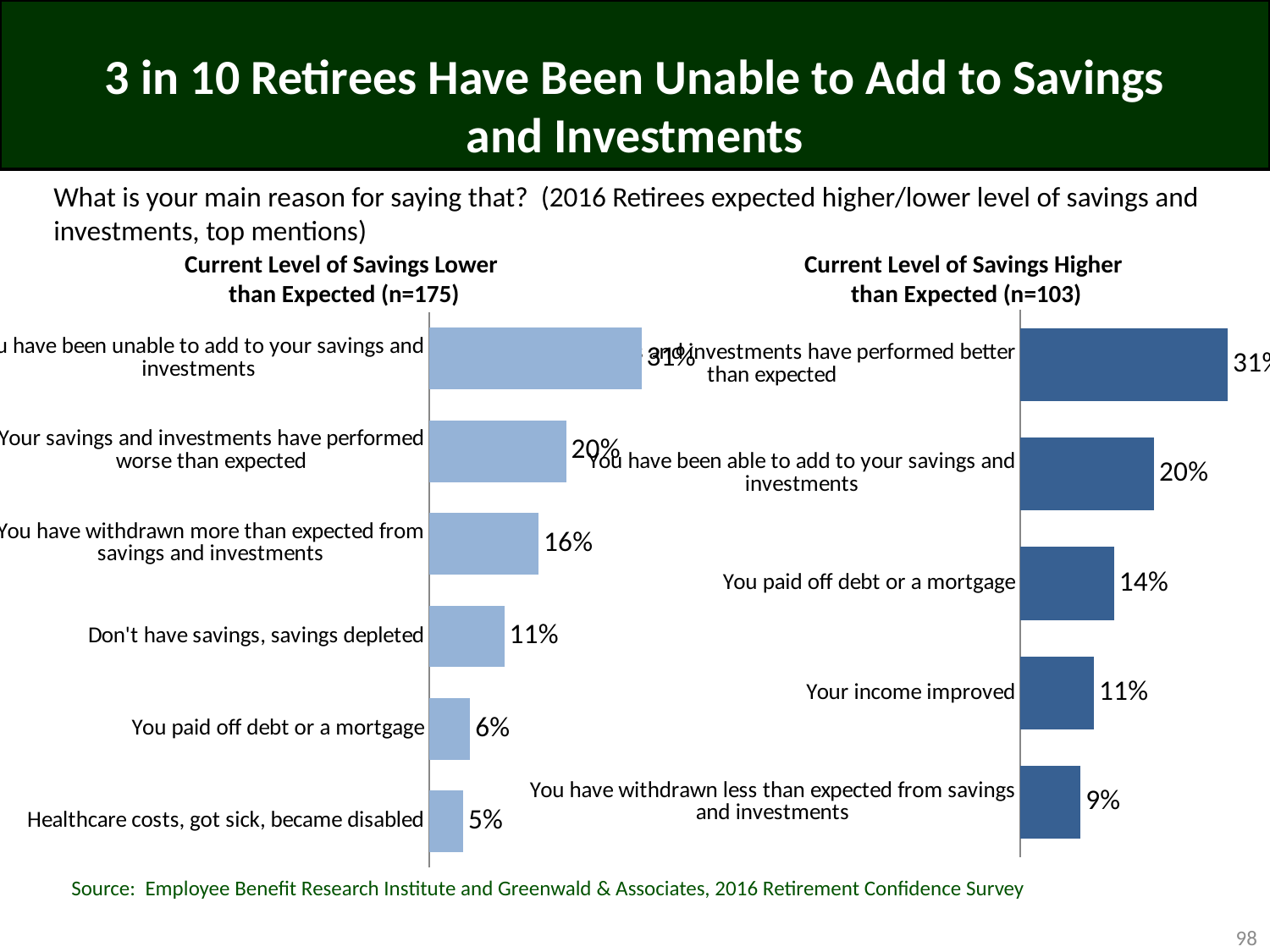
In the 'Current Level of Savings Higher than Expected' chart, what percentage cited 'Your income improved'? 11% In the 'Current Level of Savings Lower than Expected' chart, what percentage cited 'Healthcare costs, got sick, became disabled'? 5% In the 'Current Level of Savings Higher than Expected' chart, which reason has the lowest percentage? You have withdrawn less than expected from savings and investments In the 'Current Level of Savings Lower than Expected' chart, what percentage cited 'Your savings and investments have performed worse than expected'? 20% What type of chart is used for the 'Current Level of Savings Higher than Expected' data? Bar chart What is the sample size (n) shown in the title of the 'Current Level of Savings Lower than Expected' chart? 175 In the 'Current Level of Savings Higher than Expected' chart, what percentage cited 'You paid off debt or a mortgage'? 14% In the 'Current Level of Savings Lower than Expected' chart, which reason has the lowest percentage? Healthcare costs, got sick, became disabled How many reasons are listed in the 'Current Level of Savings Higher than Expected' chart? 5 In the 'Current Level of Savings Lower than Expected' chart, what is the difference between 'You have withdrawn more than expected from savings and investments' and 'Don't have savings, savings depleted'? 5 percentage points How many reasons are listed in the 'Current Level of Savings Lower than Expected' chart? 6 Which is larger: 'You paid off debt or a mortgage' in the 'Savings Lower than Expected' chart or 'You paid off debt or a mortgage' in the 'Savings Higher than Expected' chart? Savings Higher than Expected (14%)